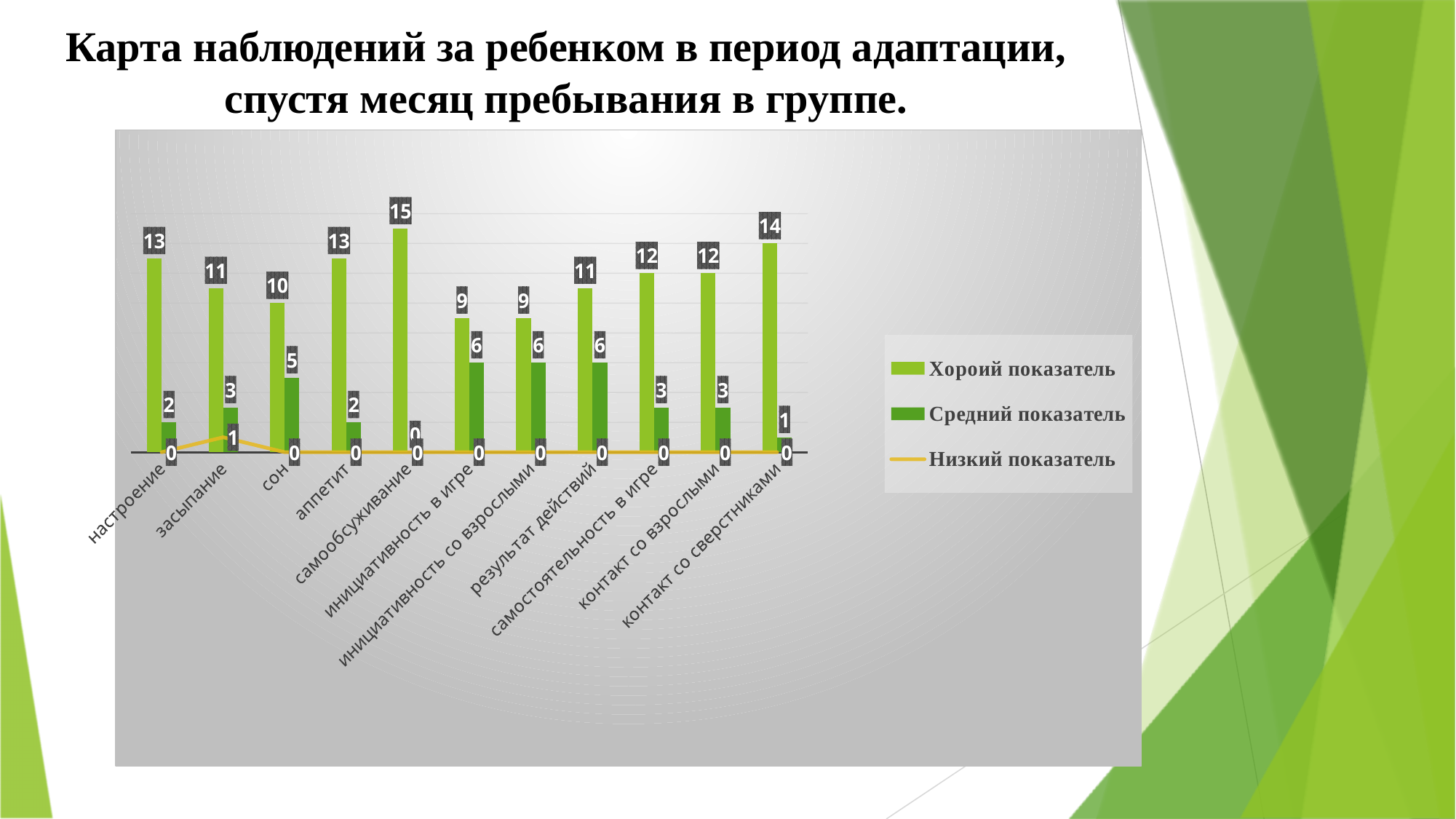
What kind of chart is shown on the slide? Combined bar and line chart Which category has the lowest Средний показатель value? самообсуживание Which series is drawn as a line rather than bars? Низкий показатель How many categories are shown on the x axis? 11 How many series does the legend list? 3 What is the value of Средний показатель for сон? 5 What is the difference between the Хороий показатель values for самообслуживание and сон? 5 What is the value of Низкий показатель for засыпание? 1 Which category has the highest Средний показатель value? инициативность в игре, инициативность со взрослыми, результат действий (all 6) Which is larger: the Хороий показатель value for настроение or for засыпание? настроение What is the value of Хороий показатель for самообслуживание? 15 Which category has the highest Хороий показатель value? самообсуживание